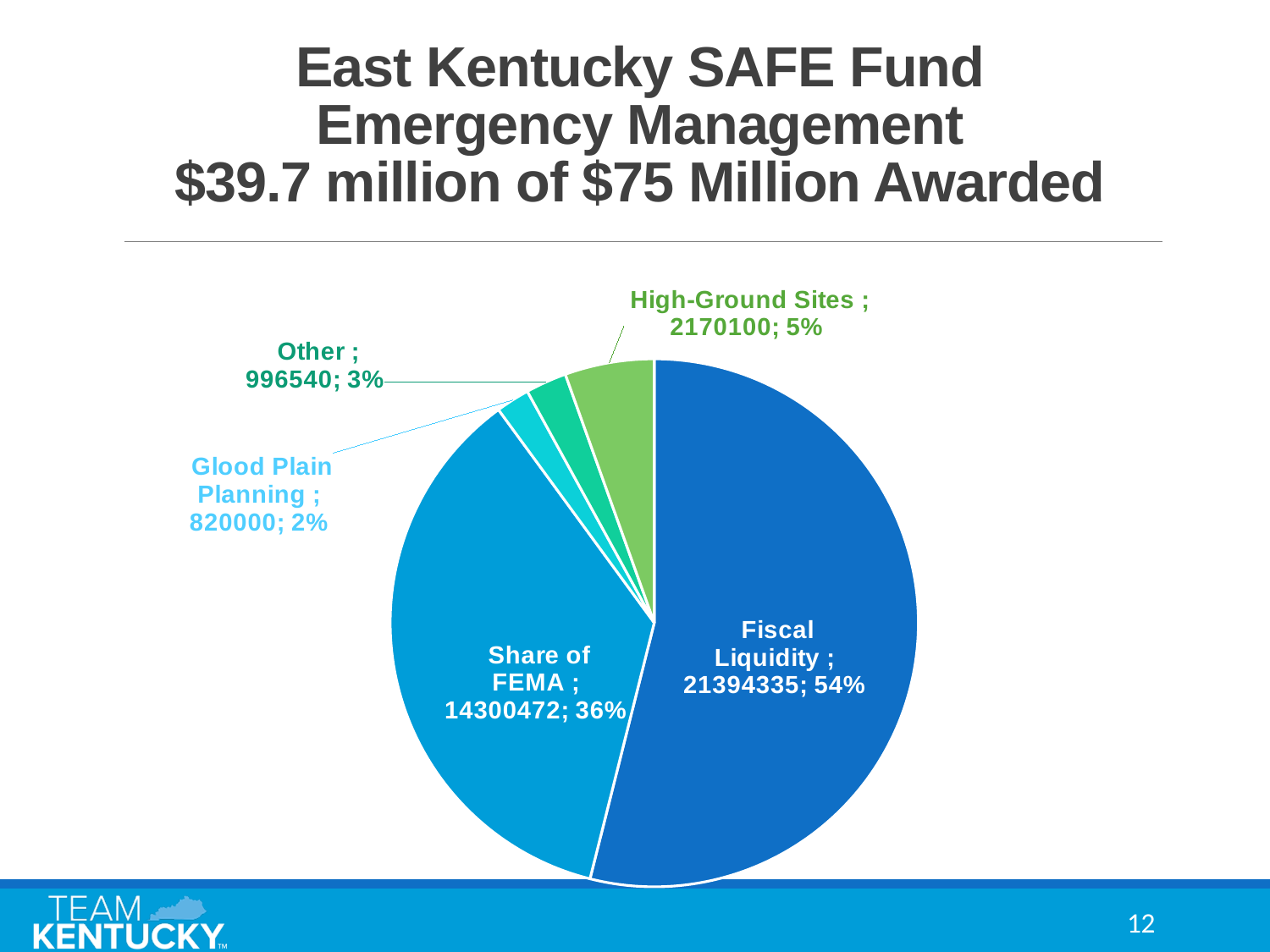
What is the value for Glood Plain Planning? 820000 How many categories are shown in the pie chart? 5 What is the value for High-Ground Sites? 2170100 Which is larger, the value for High-Ground Sites or the value for Other? High-Ground Sites Which category has the smallest slice of the pie? Glood Plain Planning What is the value for Share of FEMA? 14300472 What share of the pie does Share of FEMA represent? 36% What is the difference between the values for Fiscal Liquidity and Share of FEMA? 7093863 What share of the pie does Other represent? 3% Which category has the largest slice of the pie? Fiscal Liquidity What is the value for Fiscal Liquidity? 21394335 What type of chart is shown on the slide? Pie chart